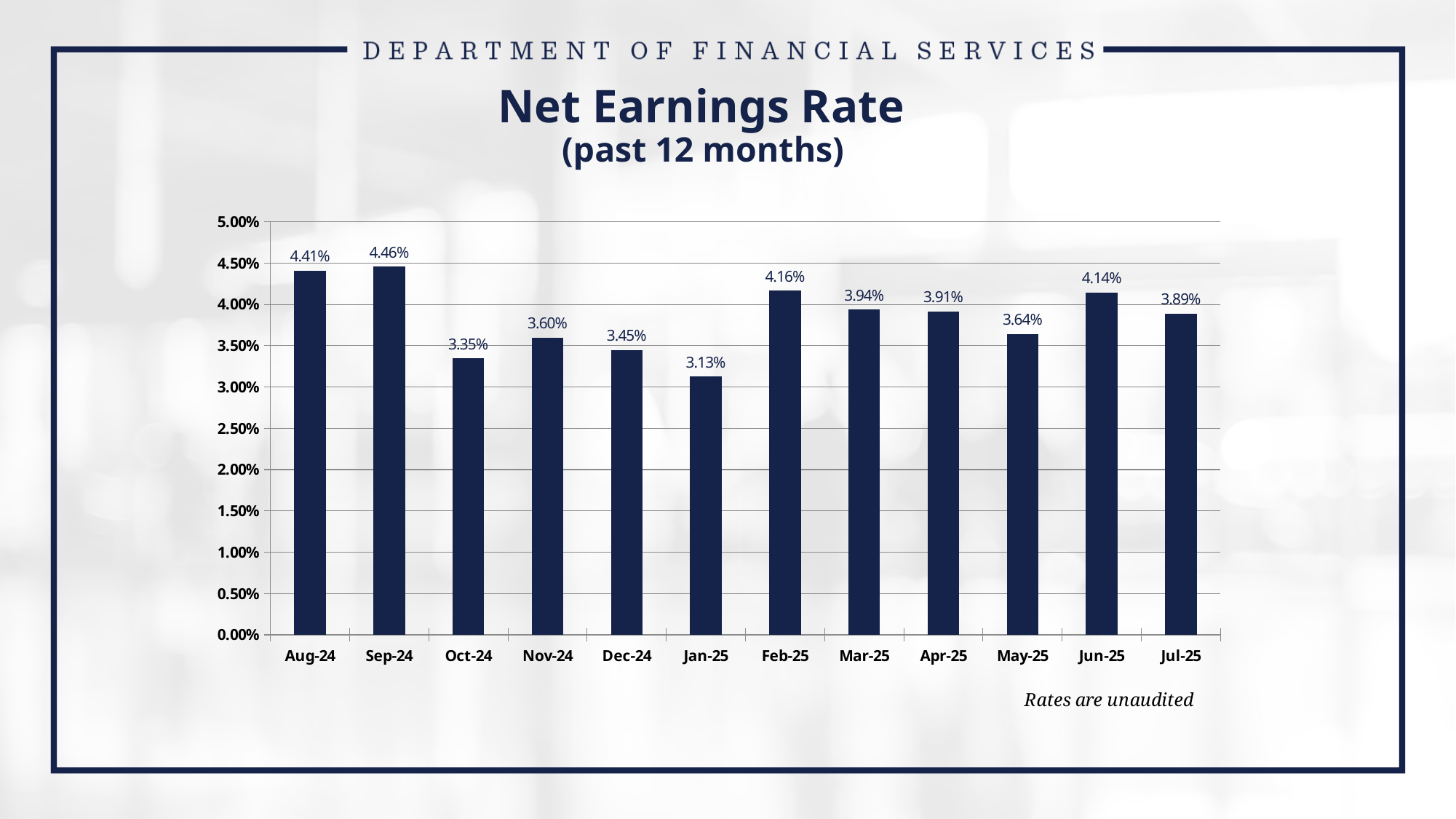
What is the title of the chart? Net Earnings Rate (past 12 months) What is the net earnings rate for Sep-24? 4.46% Which is larger, the net earnings rate for Nov-24 or Dec-24? Nov-24 Which month has the lowest net earnings rate? Jan-25 What is the net earnings rate for Jul-25? 3.89% What is the net earnings rate for Jan-25? 3.13% What is the difference between the net earnings rate in Sep-24 and Jan-25? 1.33% Is the value for May-25 greater or less than 3.50%? greater Which month has the highest net earnings rate? Sep-24 What kind of chart is shown on the slide? Bar chart What is the difference between the net earnings rate in Feb-25 and Mar-25? 0.22% How many months are shown on the chart? 12